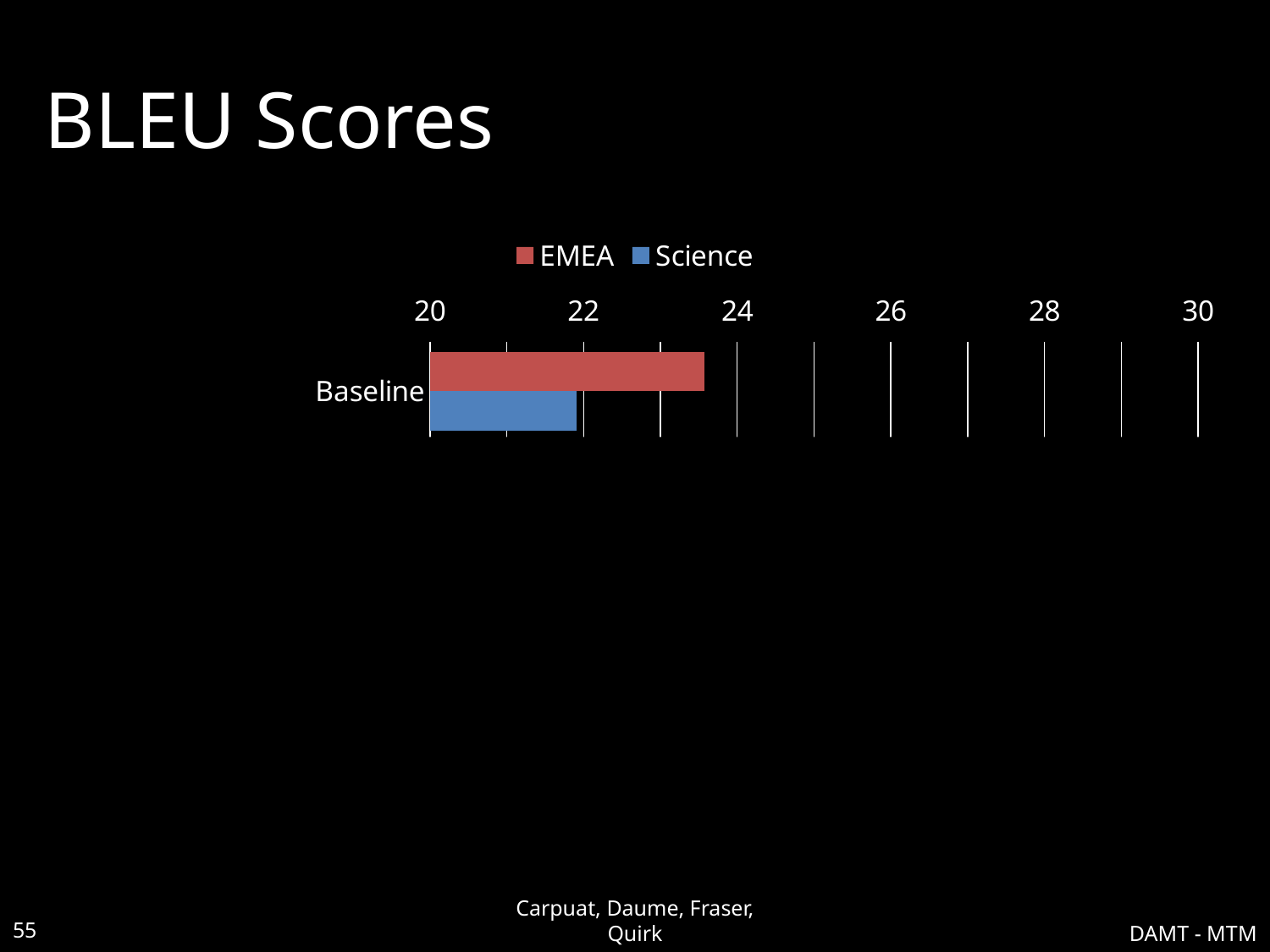
Is the Science value for Baseline greater or less than 20? greater How many series does the legend list? 2 Which series has the larger value for Baseline, EMEA or Science? EMEA What kind of chart is shown on the slide? bar chart What is the highest value shown on the chart's axis? 30 How many categories are plotted on the chart? 1 Is the Science value for Baseline greater or less than 24? less Is the EMEA value for Baseline greater or less than 22? greater What is the name of the only category shown on the chart? Baseline What colour represents the EMEA series in the chart? red What is the title of the slide containing the chart? BLEU Scores